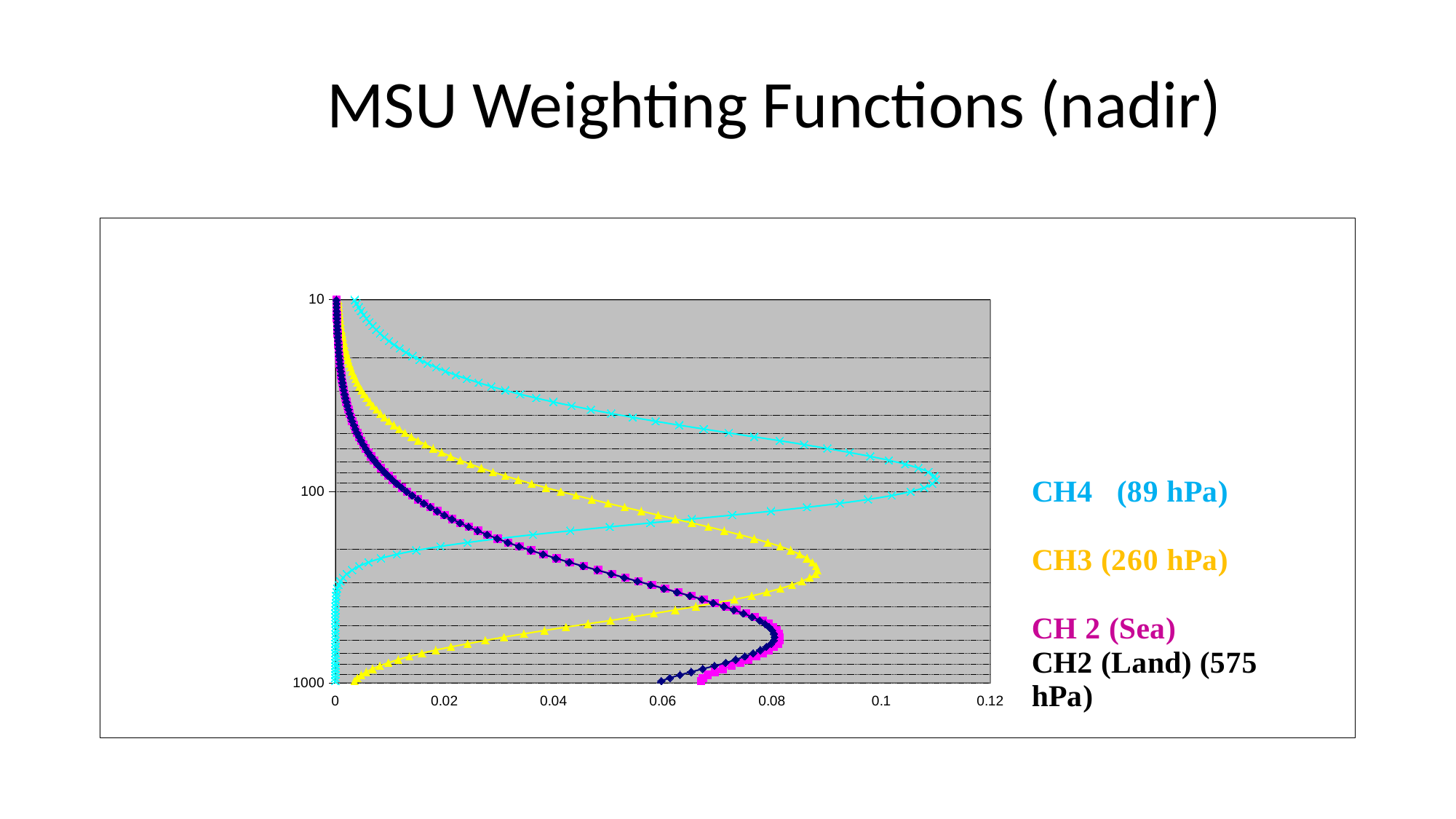
Is the peak value of the CH4 curve greater or less than 0.1? greater Is the peak value of the CH2 (Land) curve greater or less than 0.1? less Which series has its peak closest to the 1000 pressure level at the bottom of the y axis? CH2 Is the peak value of the CH3 curve greater or less than 0.1? less What is the maximum value shown on the x axis? 0.12 How many series are labelled beside the chart? 4 What kind of chart is shown on the slide? line chart What is the title of the slide containing the chart? MSU Weighting Functions (nadir) Which series reaches the largest value on the x axis? CH4 (89 hPa) What pressure level is given in the label for CH3? 260 hPa Which series peaks at a larger x value, CH4 or CH3? CH4